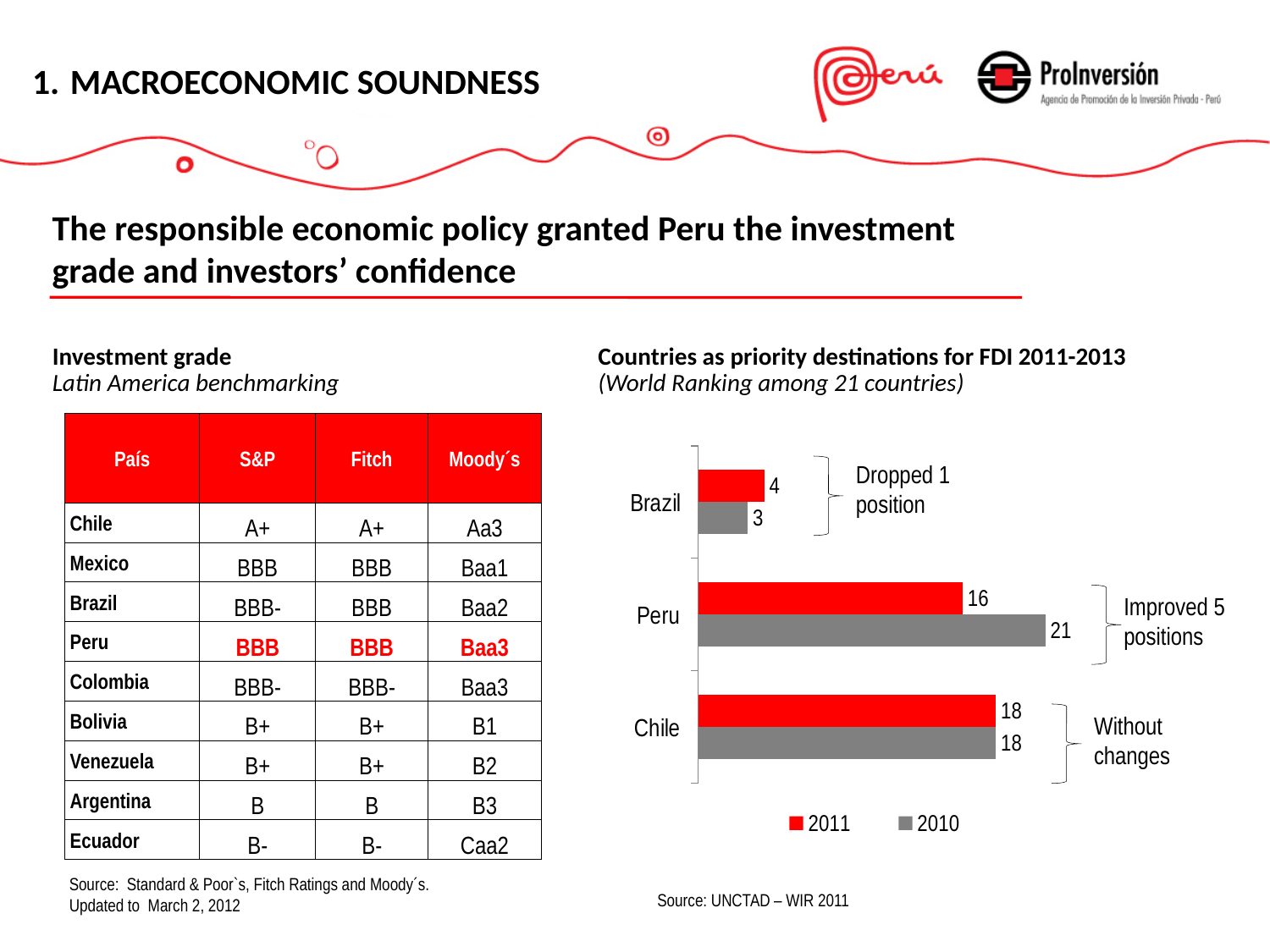
In the FDI priority destinations chart, which country has the lowest 2011 value? Brazil In the FDI priority destinations chart, which colour represents the 2011 series? red In the FDI priority destinations chart, which country has the highest 2010 value? Peru How many series does the legend of the FDI priority destinations chart list? 2 How many countries are shown in the FDI priority destinations chart? 3 In the FDI priority destinations chart, what is the 2011 value for Brazil? 4 In the FDI priority destinations chart, is Brazil's 2011 value larger or smaller than its 2010 value? larger In the FDI priority destinations chart, what is the difference between Peru's 2010 and 2011 values? 5 In the FDI priority destinations chart, what is the 2011 value for Peru? 16 In the FDI priority destinations chart, what is the 2010 value for Peru? 21 In the FDI priority destinations chart, what is the 2010 value for Chile? 18 What kind of chart is shown under the title "Countries as priority destinations for FDI 2011-2013"? bar chart